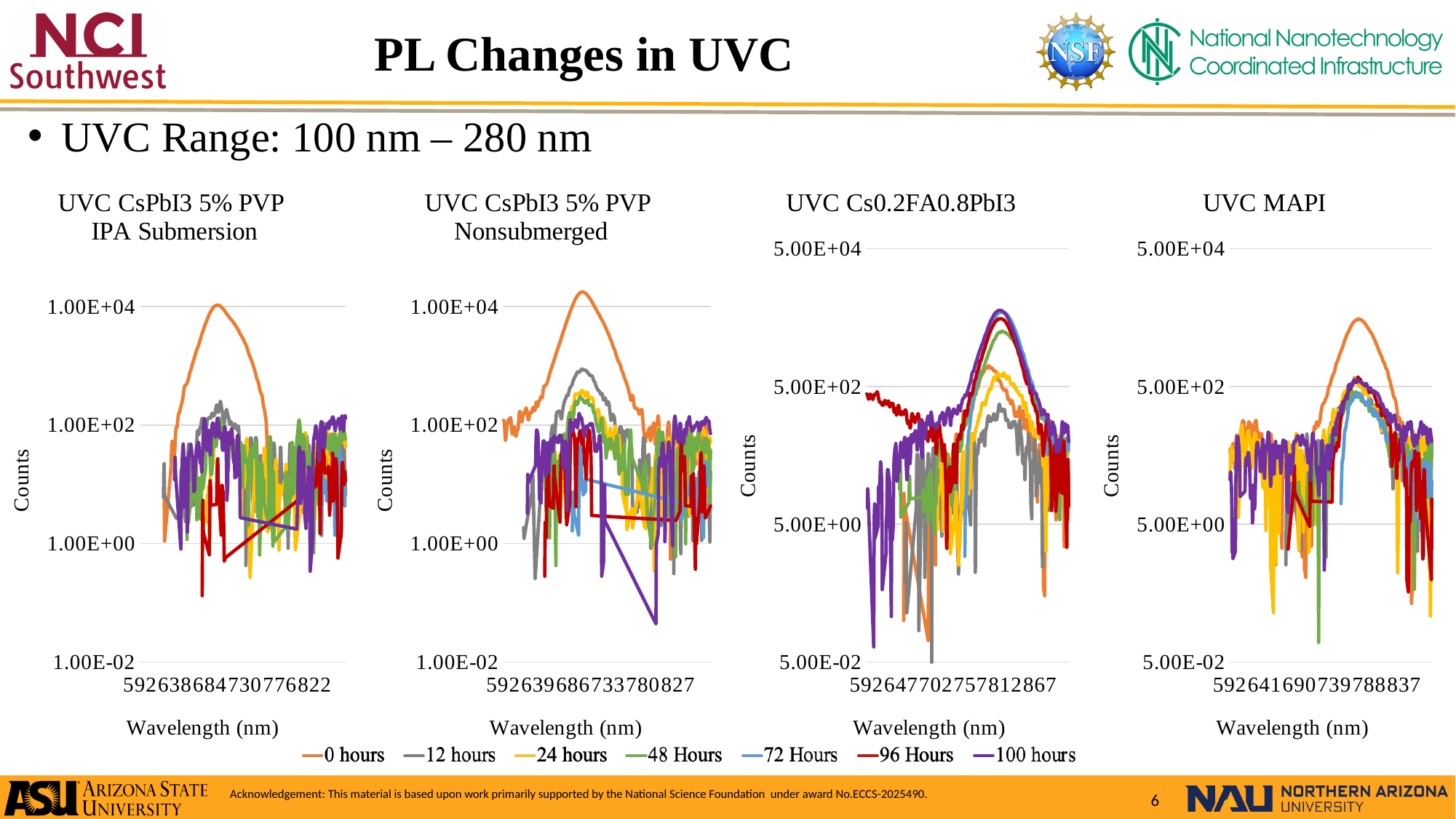
What is the x-axis label of the "UVC Cs0.2FA0.8PbI3" chart? Wavelength (nm) In the "UVC CsPbI3 5% PVP IPA Submersion" chart, which series has a higher peak, 0 hours or 12 hours? 0 hours In the "UVC MAPI" chart, is the peak value of the 0 hours series greater or less than 5.00E+02? greater In the "UVC CsPbI3 5% PVP IPA Submersion" chart, which series has the highest peak? 0 hours In the "UVC MAPI" chart, which series has the highest peak? 0 hours How many series does the shared legend list? 7 How many charts are shown on the slide? 4 In the "UVC CsPbI3 5% PVP Nonsubmerged" chart, is the peak value of the 0 hours series greater or less than 1.00E+04? greater In the "UVC CsPbI3 5% PVP Nonsubmerged" chart, which series has the highest peak? 0 hours What is the title of the rightmost chart on the slide? UVC MAPI In the "UVC Cs0.2FA0.8PbI3" chart, is the peak value of the 12 hours series greater or less than 5.00E+02? less What kind of chart is the "UVC CsPbI3 5% PVP IPA Submersion" chart? line chart